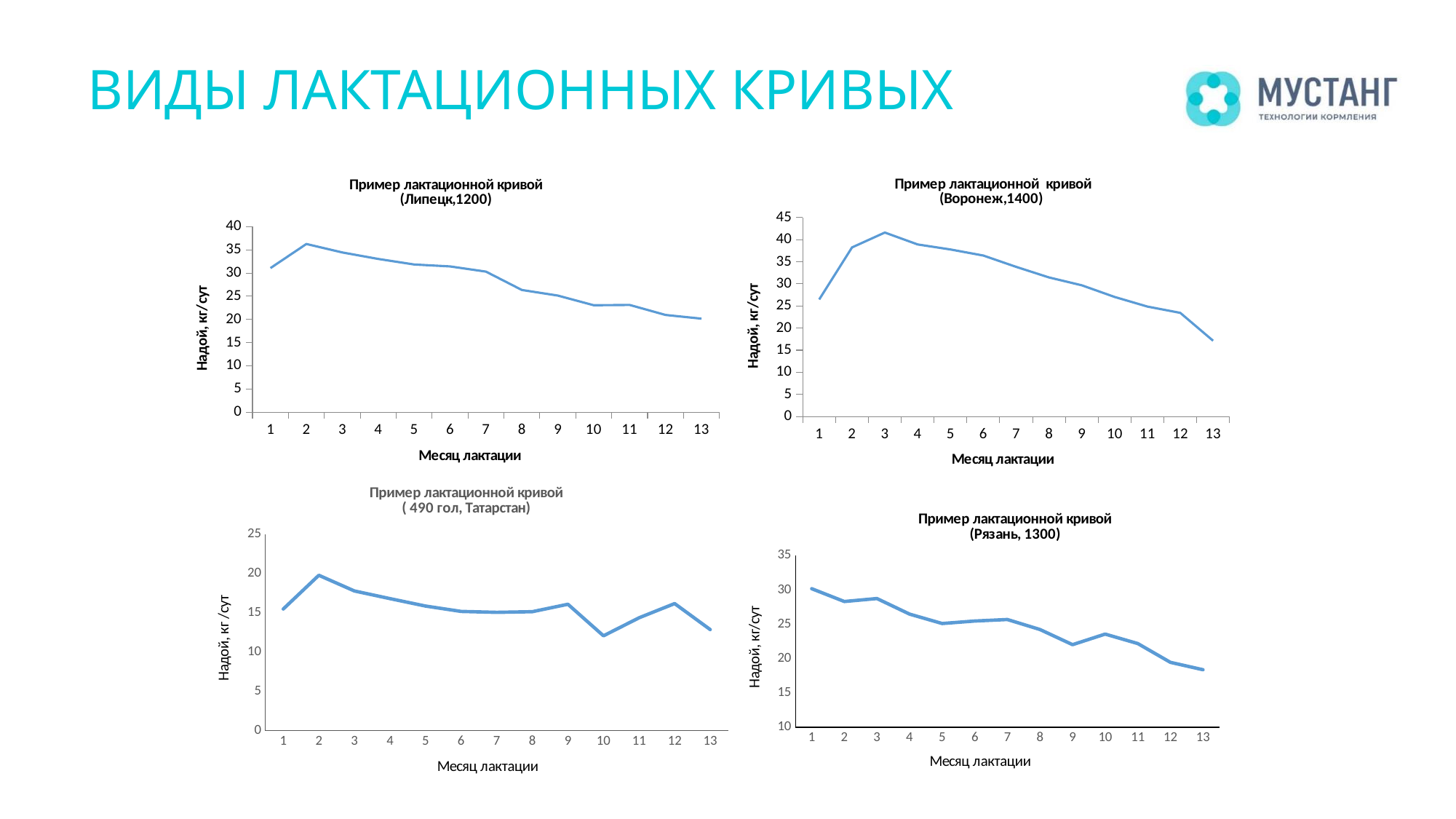
What kind of chart is the chart titled "Пример лактационной кривой (Липецк,1200)"? line chart In the chart titled "Пример лактационной кривой (Рязань, 1300)", do the values overall rise or fall from month 1 to month 13? fall In the chart titled "Пример лактационной кривой ( 490 гол, Татарстан)", is the value for month 13 greater or less than 15? less In the chart titled "Пример лактационной кривой ( 490 гол, Татарстан)", at which month of lactation is the milk yield lowest? 10 How many months of lactation are plotted on the x axis of the chart titled "Пример лактационной кривой (Воронеж,1400)"? 13 In the chart titled "Пример лактационной кривой (Липецк,1200)", at which month of lactation is the milk yield highest? 2 In the chart titled "Пример лактационной кривой (Рязань, 1300)", at which month of lactation is the milk yield lowest? 13 In the chart titled "Пример лактационной кривой (Воронеж,1400)", at which month of lactation is the milk yield lowest? 13 In the chart titled "Пример лактационной кривой (Липецк,1200)", is the value for month 10 greater or less than 25? less In the chart titled "Пример лактационной кривой (Воронеж,1400)", at which month of lactation is the milk yield highest? 3 In the chart titled "Пример лактационной кривой (Воронеж,1400)", is the value for month 13 greater or less than 20? less What is the y-axis label of the chart titled "Пример лактационной кривой (Рязань, 1300)"? Надой, кг/сут